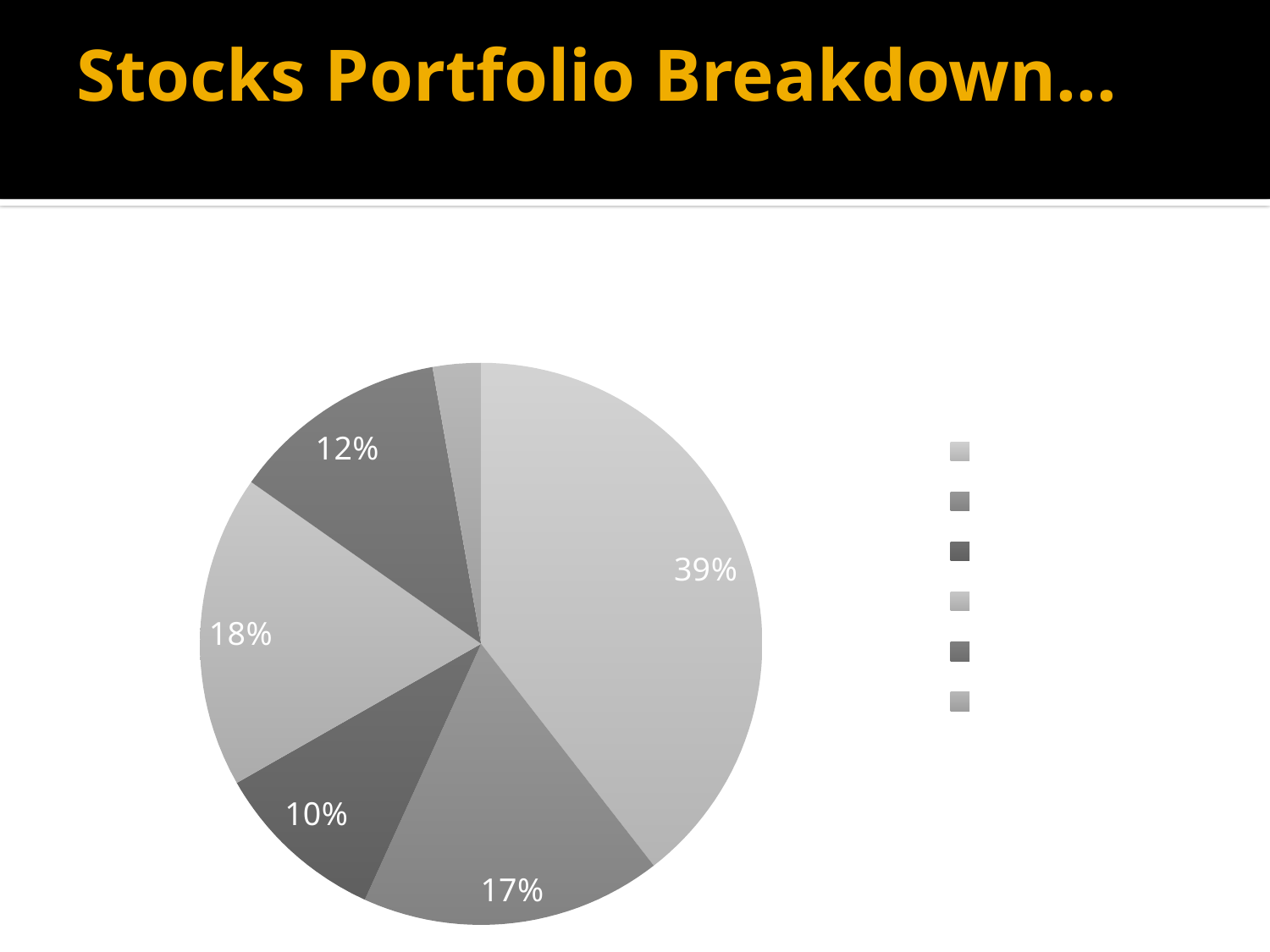
How many slices does the pie chart have? 6 Among the percentage labels printed on the pie chart, which is the smallest? 10% Which is larger, the slice labeled 18% or the slice labeled 17%? 18% What is the difference between the largest slice (39%) and the slice labeled 17%? 22% How many slices of the pie chart have a printed percentage label? 5 Does the legend show any readable text labels next to its colour markers? No What is the title of the slide containing the chart? Stocks Portfolio Breakdown… What do the five printed percentage labels on the pie chart add up to? 96% What is the difference between the slice labeled 18% and the slice labeled 12%? 6% How many entries does the legend list? 6 What is the percentage of the largest slice in the pie chart? 39% What kind of chart is shown on the slide? pie chart